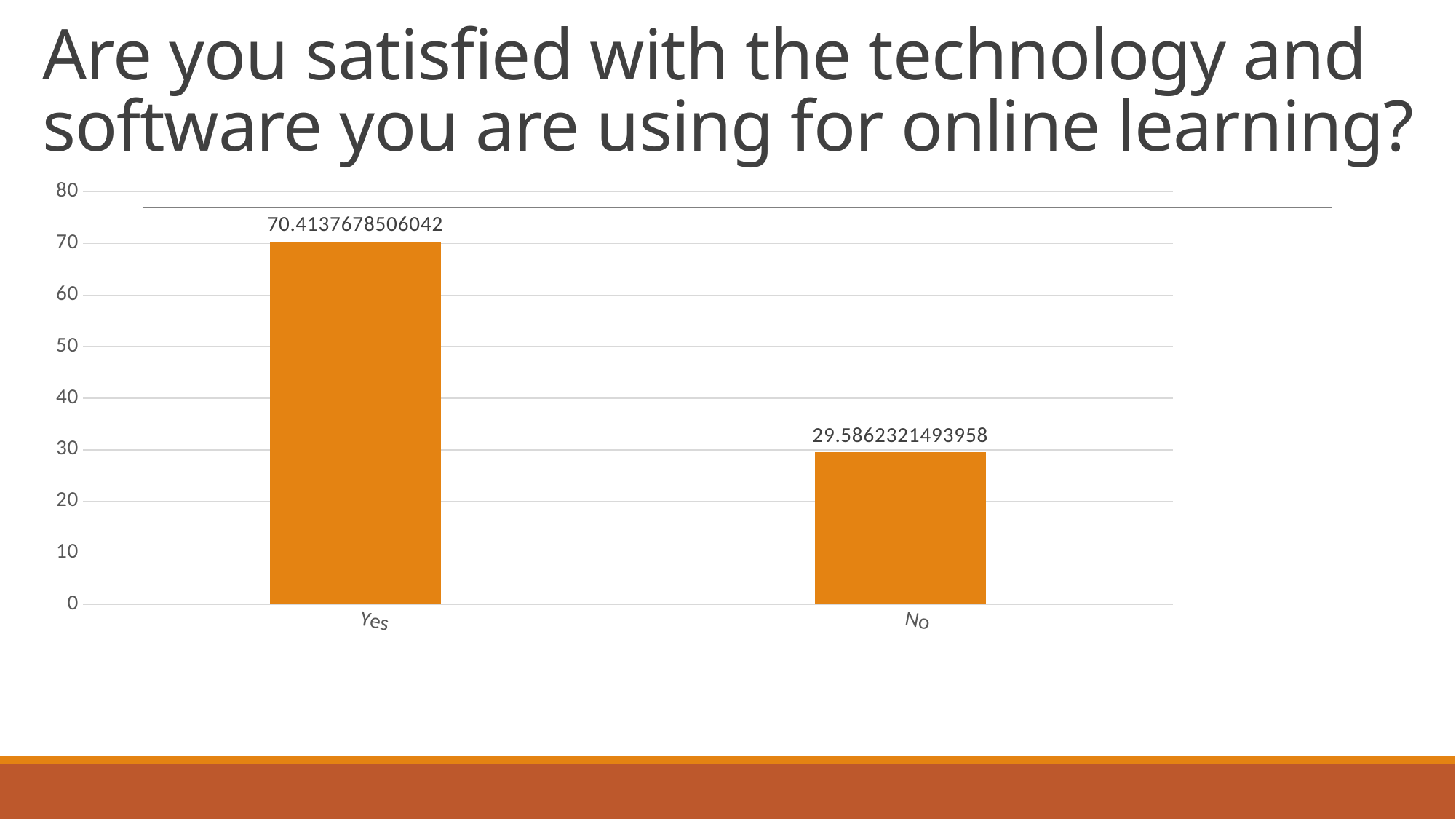
What colour are the bars in the chart? orange What kind of chart is shown on the slide? bar chart What is the value for Yes? 70.4137678506042 What is the difference between the value for Yes and the value for No? 40.8275357012084 What is the highest value shown on the vertical axis? 80 How many categories are shown on the x axis? 2 Is the value for No greater or less than 40? less Which category has the highest value? Yes Is the value for Yes greater or less than 60? greater Which is larger, the value for Yes or the value for No? Yes What is the value for No? 29.5862321493958 Which category has the lowest value? No